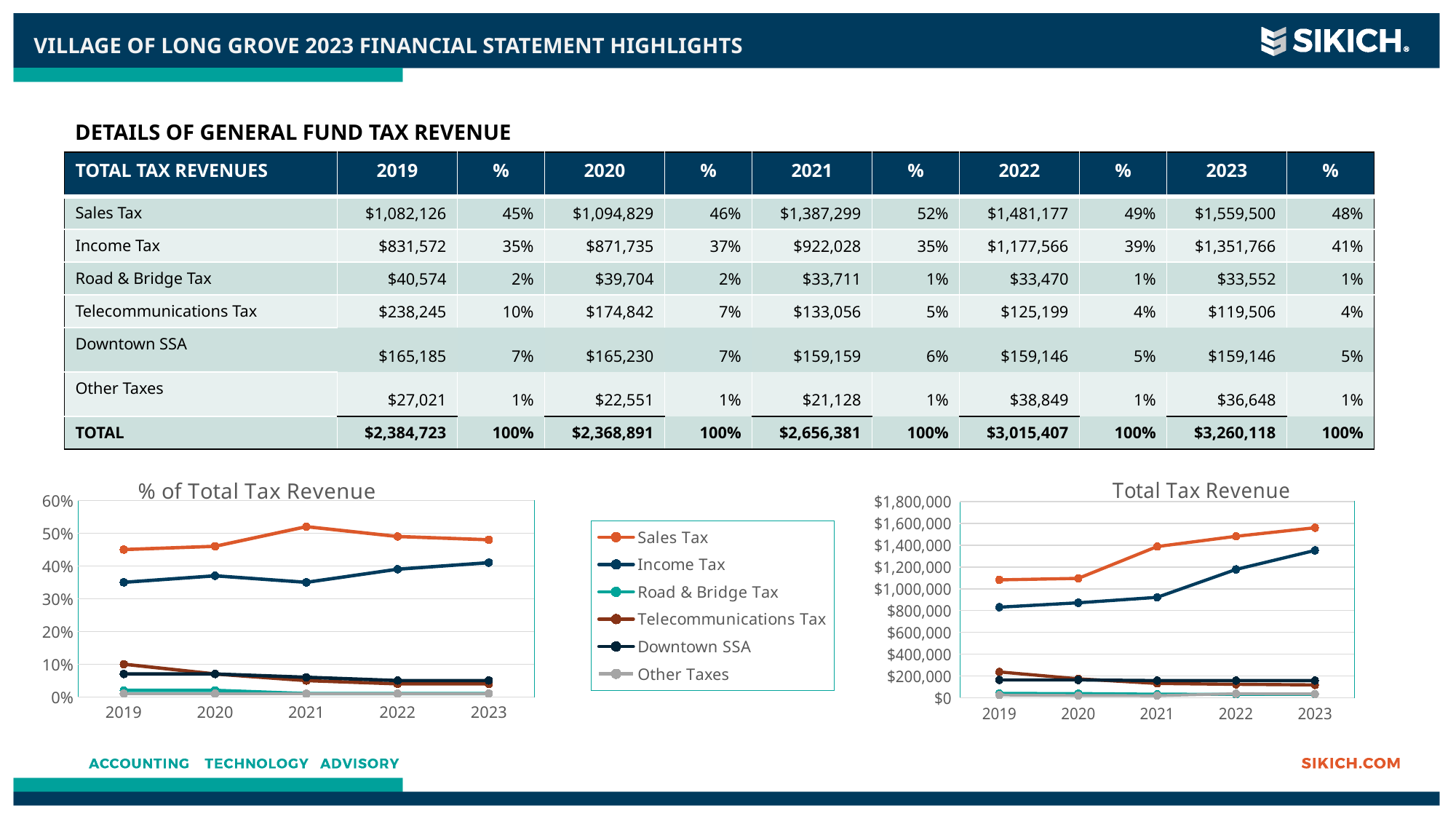
In the 'Total Tax Revenue' chart, does the Income Tax line rise or fall from 2019 to 2023? rises In the '% of Total Tax Revenue' chart, which is larger in 2021: Sales Tax or Income Tax? Sales Tax In the 'Total Tax Revenue' chart, which series is highest in 2023? Sales Tax In the '% of Total Tax Revenue' chart, does the Telecommunications Tax line rise or fall from 2019 to 2023? falls How many years are plotted along the x axis of the 'Total Tax Revenue' chart? 5 How many series does the legend between the two charts list? 6 What is the title of the chart on the right side of the slide? Total Tax Revenue In the '% of Total Tax Revenue' chart, is the value for Sales Tax in 2021 greater or less than 50%? greater In the 'Total Tax Revenue' chart, is the value for Sales Tax in 2019 greater or less than $1,200,000? less In the '% of Total Tax Revenue' chart, which series is highest in 2021? Sales Tax In the 'Total Tax Revenue' chart, is the value for Income Tax in 2023 greater or less than $1,200,000? greater What kind of chart is the '% of Total Tax Revenue' chart? line chart